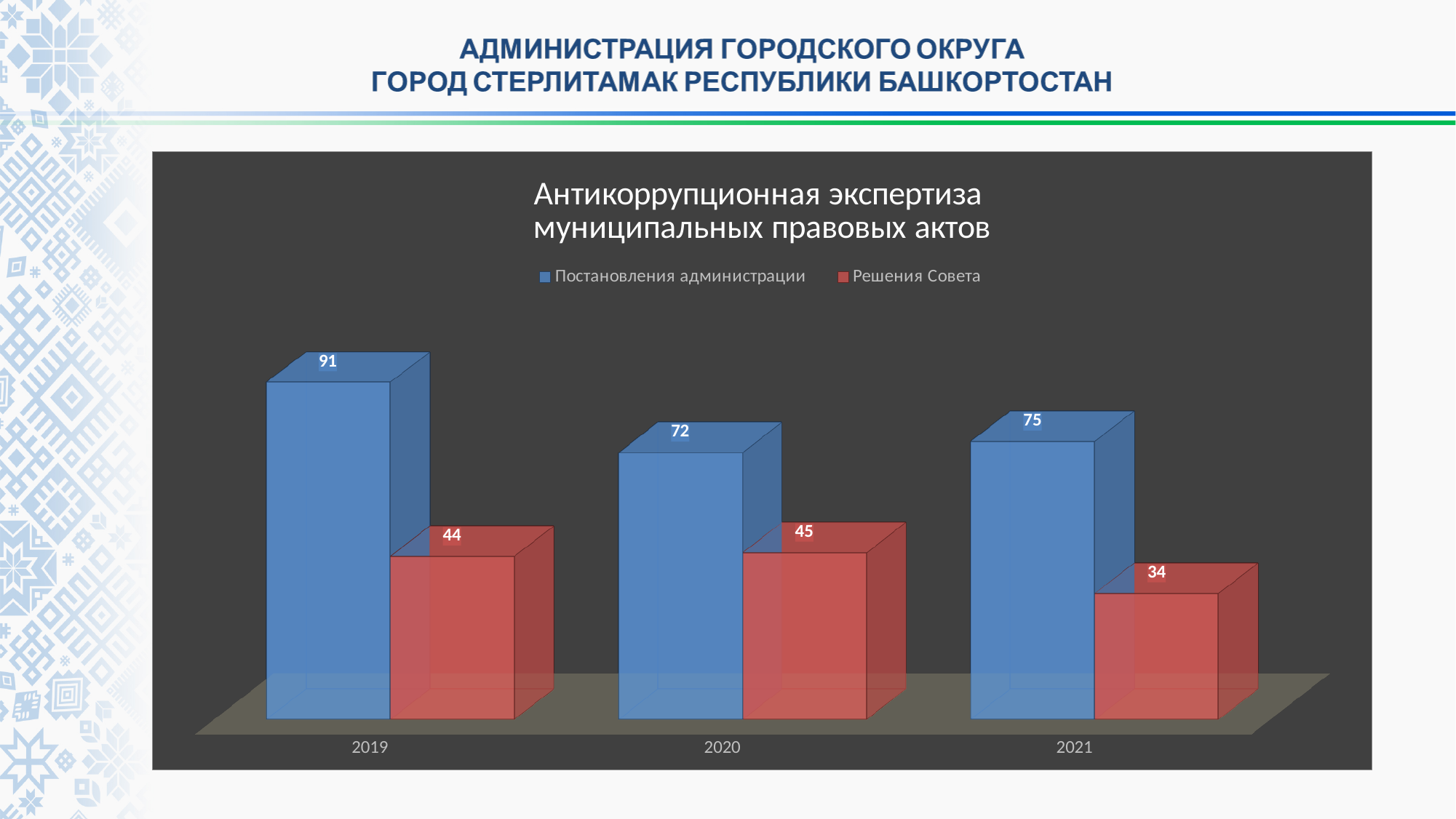
What is the value for Решения Совета in 2020? 45 How many series does the legend list? 2 How many years are shown on the x axis? 3 Which is larger in 2021: Постановления администрации or Решения Совета? Постановления администрации What is the value for Решения Совета in 2021? 34 What kind of chart is shown on the slide? Bar chart In which year is the value for Решения Совета lowest? 2021 What is the value for Постановления администрации in 2019? 91 What is the title of the chart? Антикоррупционная экспертиза муниципальных правовых актов In which year is the value for Постановления администрации highest? 2019 What is the difference between the Постановления администрации values for 2019 and 2020? 19 What is the difference between Постановления администрации and Решения Совета in 2019? 47